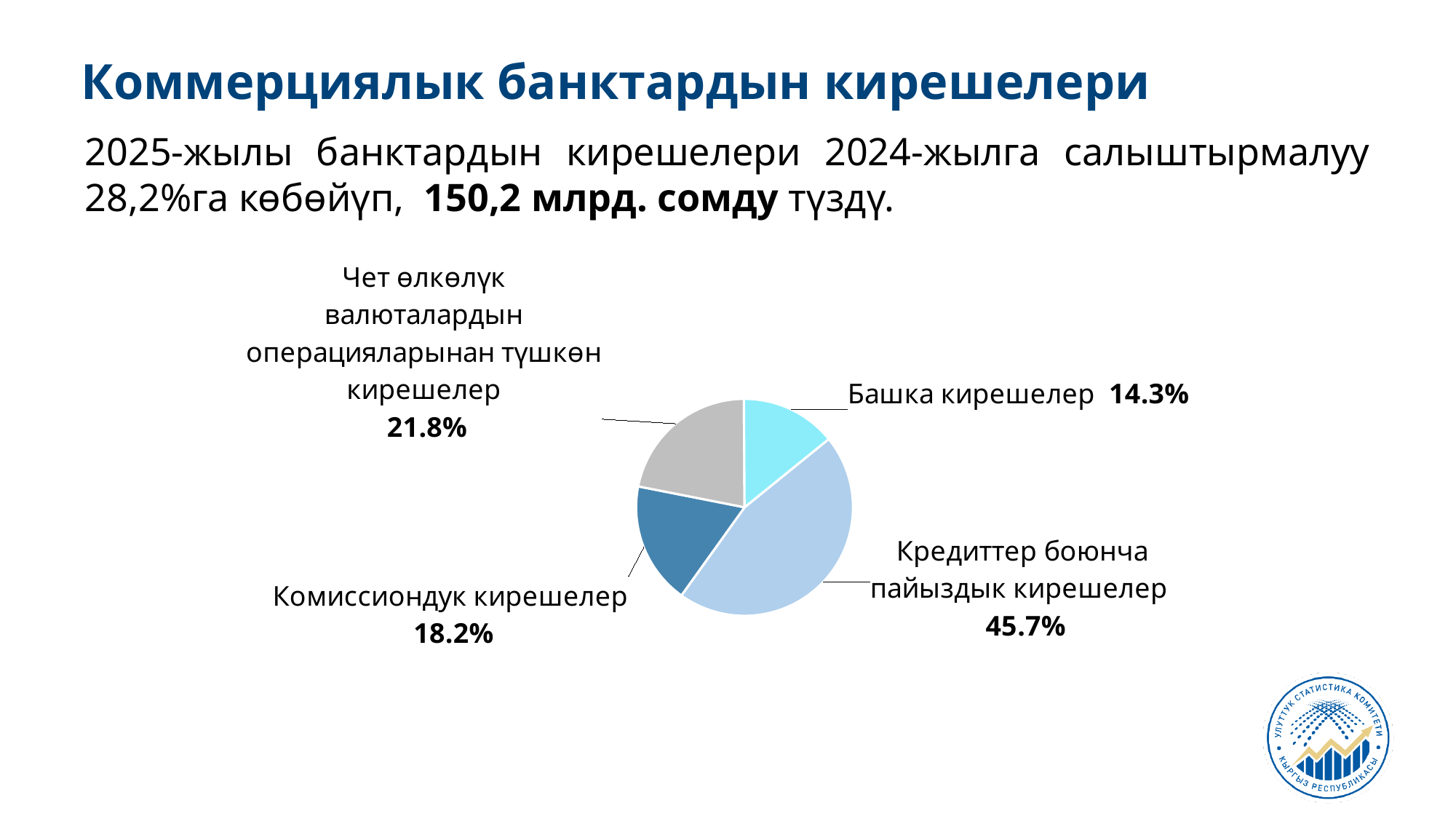
How many slices does the pie chart have? 4 What kind of chart is shown on the slide? pie chart Which is larger: the share for "Чет өлкөлүк валюталардын операцияларынан түшкөн кирешелер" or for "Башка кирешелер"? Чет өлкөлүк валюталардын операцияларынан түшкөн кирешелер What share of the pie is labelled "Комиссиондук кирешелер"? 18.2% What colour is the slice for "Комиссиондук кирешелер"? dark blue What is the difference in percentage points between "Чет өлкөлүк валюталардын операцияларынан түшкөн кирешелер" and "Башка кирешелер"? 7.5 What share of the pie is labelled "Башка кирешелер"? 14.3% What share of the pie is labelled "Чет өлкөлүк валюталардын операцияларынан түшкөн кирешелер"? 21.8% Which slice of the pie is the largest? Кредиттер боюнча пайыздык кирешелер Which slice of the pie is the smallest? Башка кирешелер What is the difference in percentage points between "Кредиттер боюнча пайыздык кирешелер" and "Комиссиондук кирешелер"? 27.5 What share of the pie is labelled "Кредиттер боюнча пайыздык кирешелер"? 45.7%